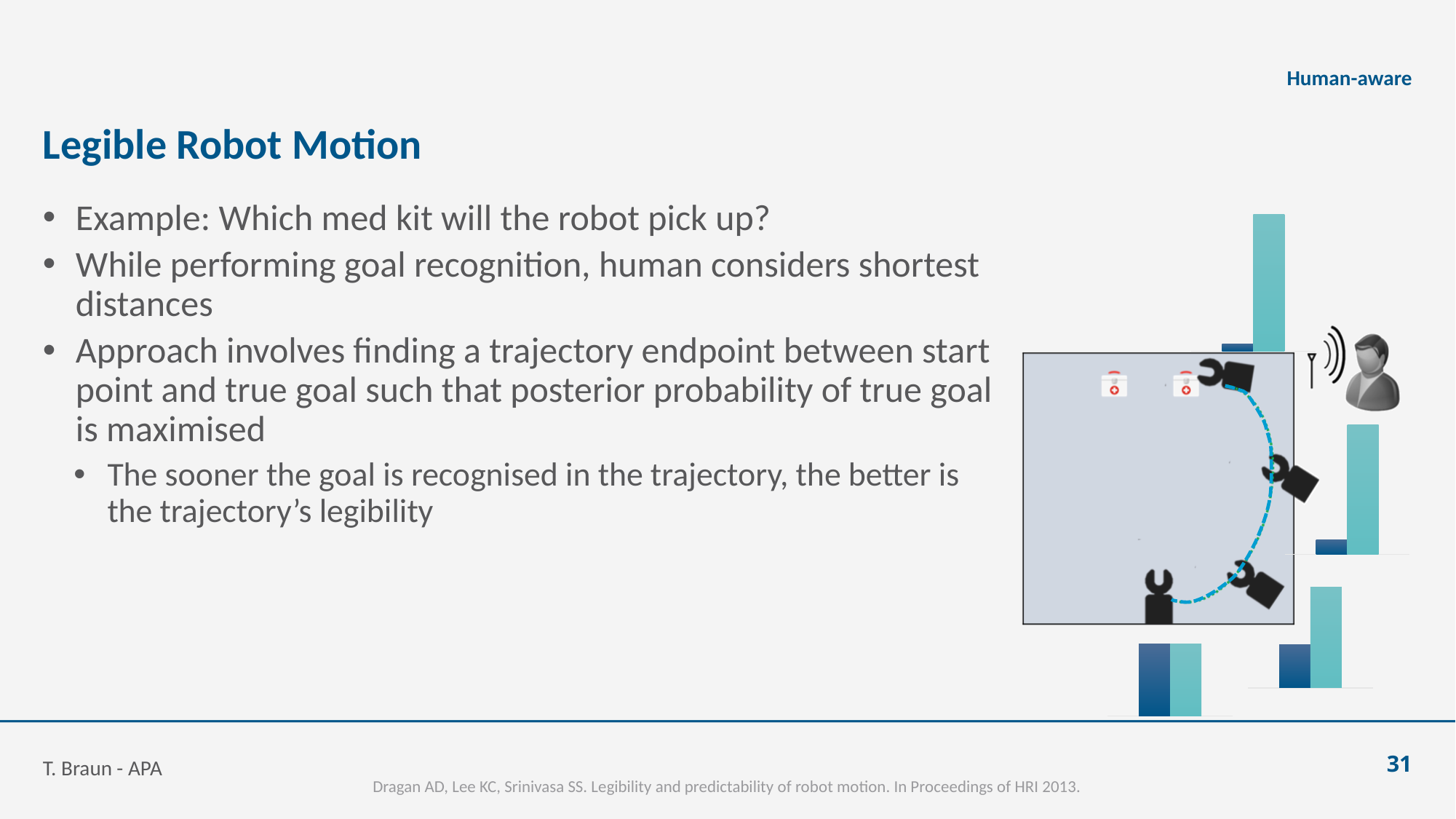
How many bars does each small bar chart on the right side of the slide contain? 2 Do the small bar charts on the slide show any axis labels or data values? No What kind of charts are the small charts on the right side of the slide? bar charts In the topmost bar chart on the right of the slide, which bar is taller, the dark blue one or the teal one? the teal one In the bottom-right bar chart on the slide, which bar is taller, the dark blue one or the teal one? the teal one What two colours are used for the bars in the small bar charts on the slide? dark blue and teal How many small bar charts are shown on the right side of the slide? 4 In the middle bar chart on the right of the slide (next to the person icon), which bar is taller, the dark blue one or the teal one? the teal one